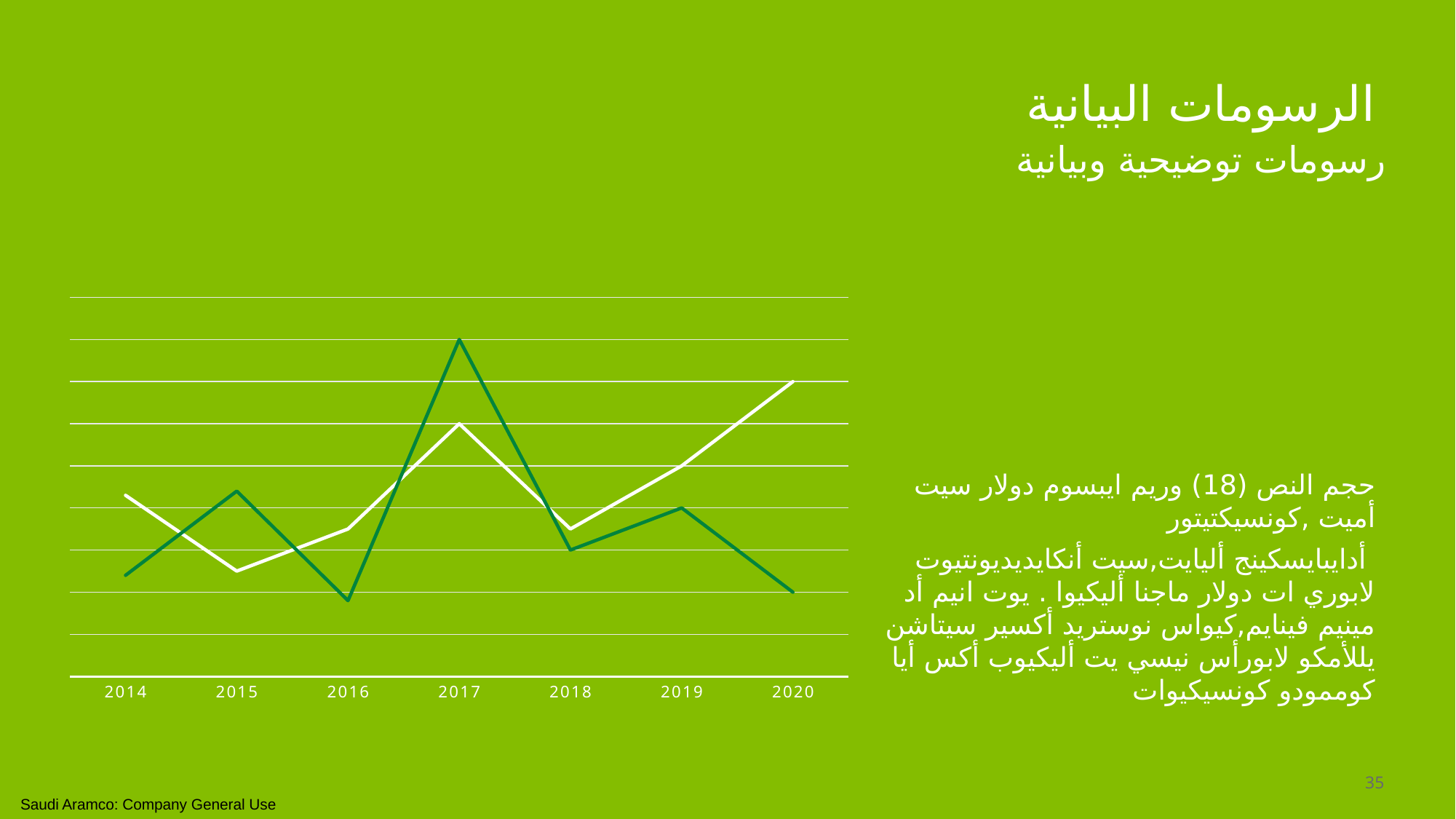
In 2017, which line is higher, the white line or the dark green line? The dark green line Does the dark green line rise or fall from 2019 to 2020? Fall In 2020, which line is higher, the white line or the dark green line? The white line How many lines are plotted on the chart? 2 In 2014, which line is higher, the white line or the dark green line? The white line How many years are shown on the x axis of the chart? 7 In which year does the dark green line reach its highest point? 2017 What is the first year shown on the x axis of the chart? 2014 Does the white line rise or fall from 2019 to 2020? Rise What kind of chart is shown on the slide? Line chart In which year does the white line reach its lowest point? 2015 In which year does the white line reach its highest point? 2020